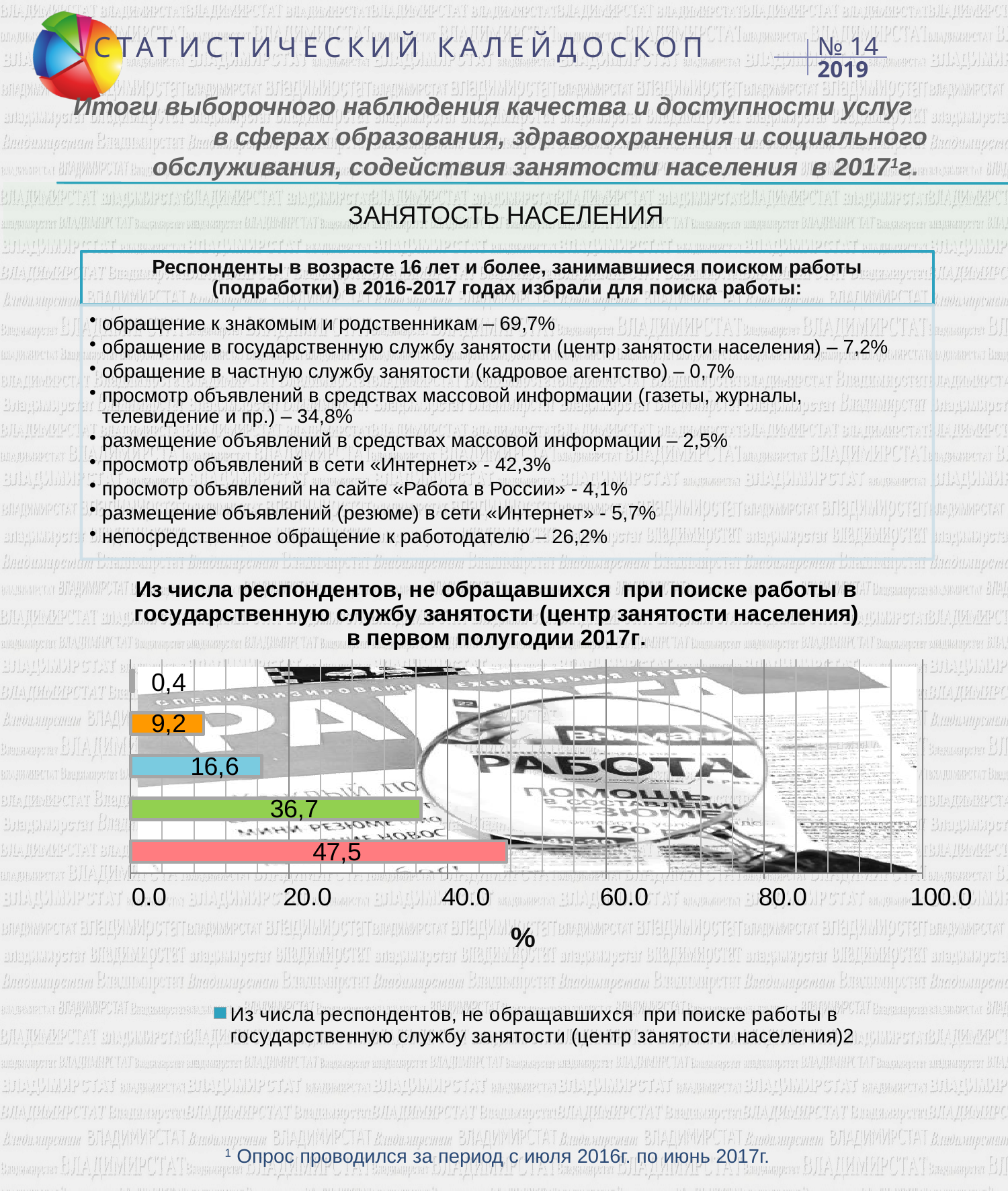
What unit is shown on the x axis of the chart? % How many bars are plotted in the chart? 5 How many series does the chart legend list? 1 Is the value of the red bar greater or less than 40.0? greater What is the value of the orange bar in the chart? 9,2 What is the value of the green bar in the chart? 36,7 What is the value of the longest (bottom, red) bar in the chart? 47,5 Which is larger, the blue bar or the orange bar? the blue bar What kind of chart is shown on the slide? bar chart What is the value of the shortest (top) bar in the chart? 0,4 What is the difference between the red bar (47,5) and the green bar (36,7)? 10,8 What is the value of the blue bar in the chart? 16,6